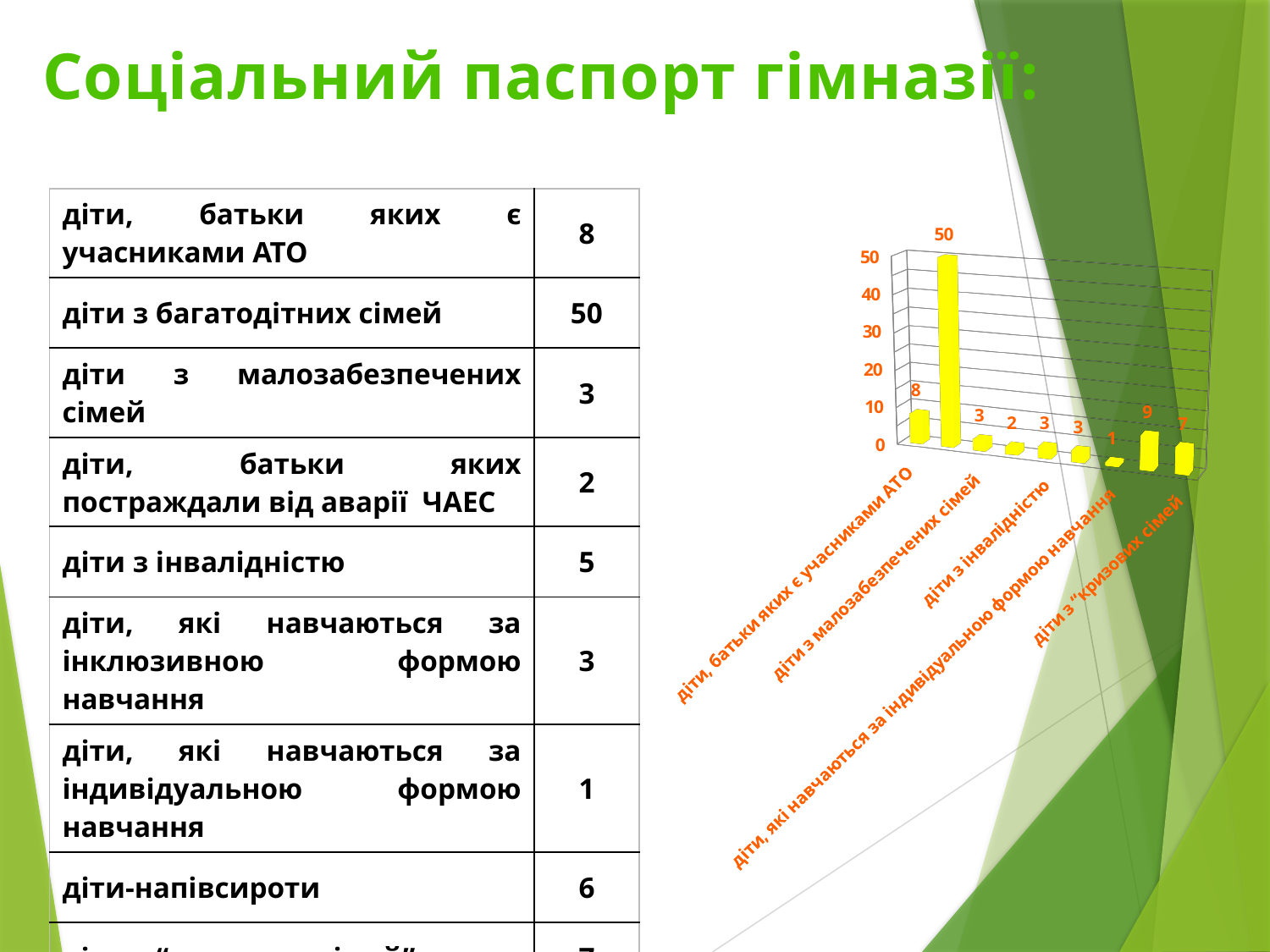
Is the tallest bar in the chart greater or less than 40? greater What colour are the bars in the chart? yellow What is the value for "діти, які навчаються за індивідуальною формою навчання" in the chart? 1 What is the difference between the highest value in the chart and the value for "діти, батьки яких є учасниками АТО"? 42 What is the value for "діти з "кризових сімей"" in the chart? 7 What is the highest value shown in the chart? 50 What is the value for "діти, батьки яких є учасниками АТО" in the chart? 8 Which has the larger value in the chart: "діти, батьки яких є учасниками АТО" or "діти з малозабезпечених сімей"? діти, батьки яких є учасниками АТО What is the value for "діти з малозабезпечених сімей" in the chart? 3 How many bars are plotted in the chart? 9 What is the difference between the value for "діти, батьки яких є учасниками АТО" and the value for "діти з малозабезпечених сімей"? 5 What kind of chart is shown on the slide? bar chart